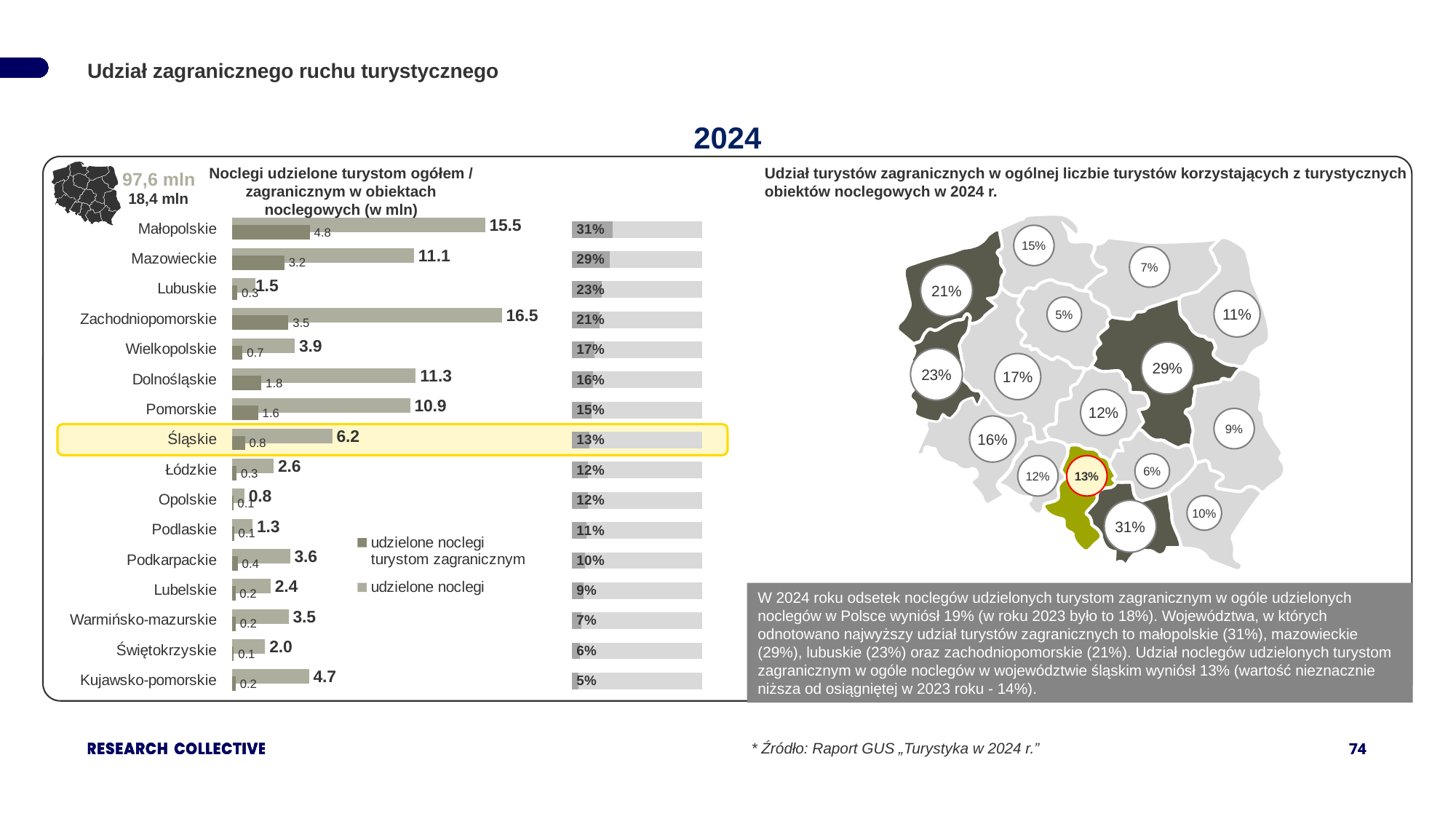
In the bar chart on the left, which voivodeship has the highest total number of overnight stays (udzielone noclegi)? Zachodniopomorskie What kind of chart is shown on the left side of the slide? Bar chart In the bar chart on the left, which voivodeship is highlighted with a yellow box? Śląskie In the bar chart on the left, what is the total number of overnight stays (udzielone noclegi) for Zachodniopomorskie? 16.5 How many series does the legend of the bar chart on the left list? 2 In the bar chart on the left, which voivodeship has the lowest total number of overnight stays (udzielone noclegi)? Opolskie In the bar chart on the left, which has more overnight stays for foreign tourists: Mazowieckie or Zachodniopomorskie? Zachodniopomorskie How many voivodeships are listed in the bar chart on the left? 16 In the bar chart on the left, what is the difference between total overnight stays and overnight stays for foreign tourists in Małopolskie? 10.7 In the bar chart on the left, how many overnight stays were given to foreign tourists (udzielone noclegi turystom zagranicznym) in Małopolskie? 4.8 On the map on the right, what percentage is shown for the voivodeship highlighted with a red circle? 13% In the percentage column next to the bar chart, what share of foreign tourists is shown for Śląskie? 13%